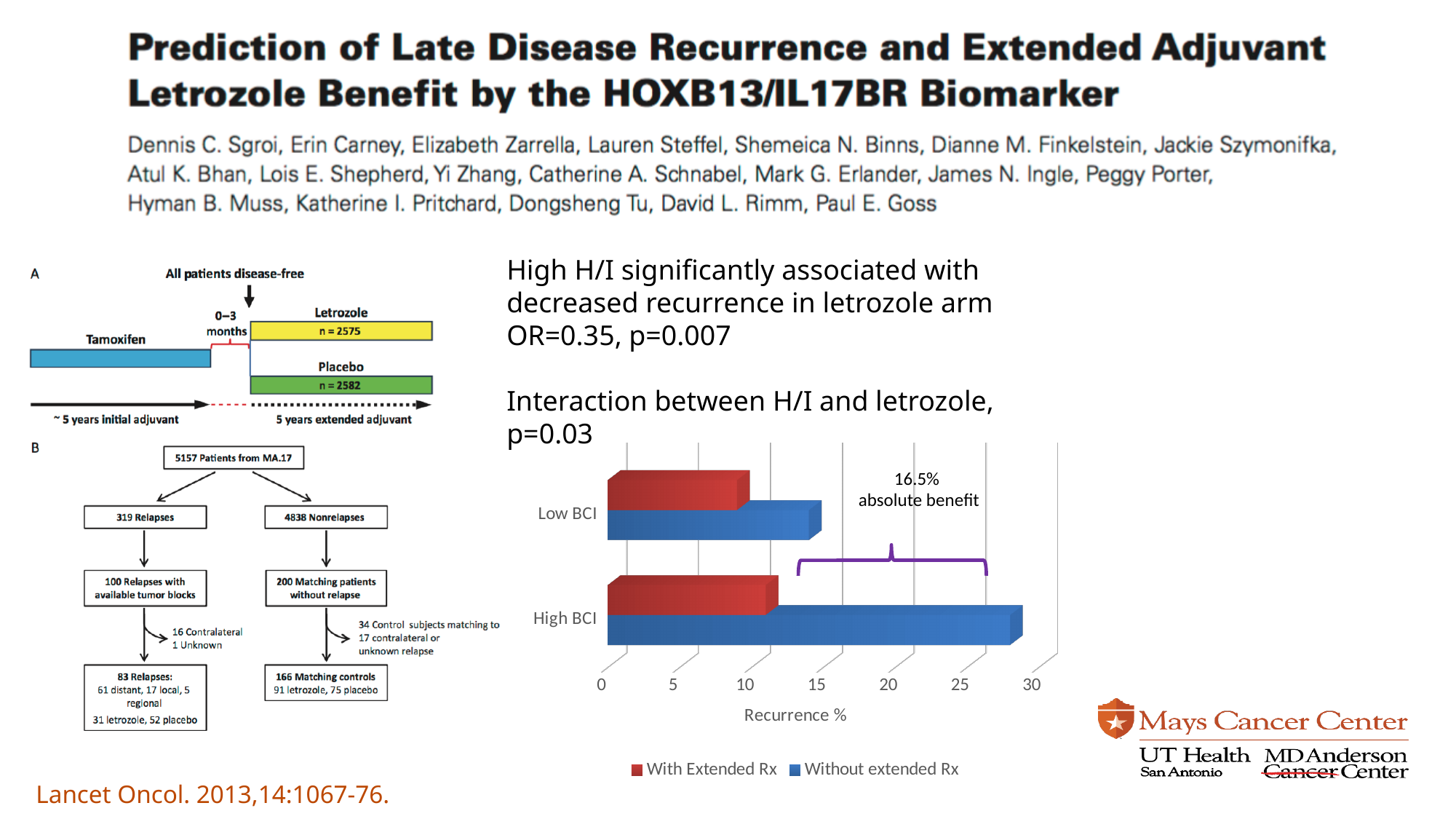
What kind of chart is shown on the right side of the slide? bar chart In the bar chart, for Low BCI, which series has the larger recurrence value: With Extended Rx or Without extended Rx? Without extended Rx In the bar chart, is the value for High BCI With Extended Rx greater or less than 15? less Which bar in the bar chart has the highest recurrence value? High BCI, Without extended Rx In the bar chart, is the value for Low BCI Without extended Rx greater or less than 10? greater How many series does the legend of the bar chart list? 2 What is the title of the x axis of the bar chart? Recurrence % In the bar chart, is the value for Low BCI With Extended Rx greater or less than 15? less In the bar chart, for High BCI, which series has the larger recurrence value: With Extended Rx or Without extended Rx? Without extended Rx How many categories are plotted on the bar chart? 2 Which series in the bar chart is shown in red? With Extended Rx